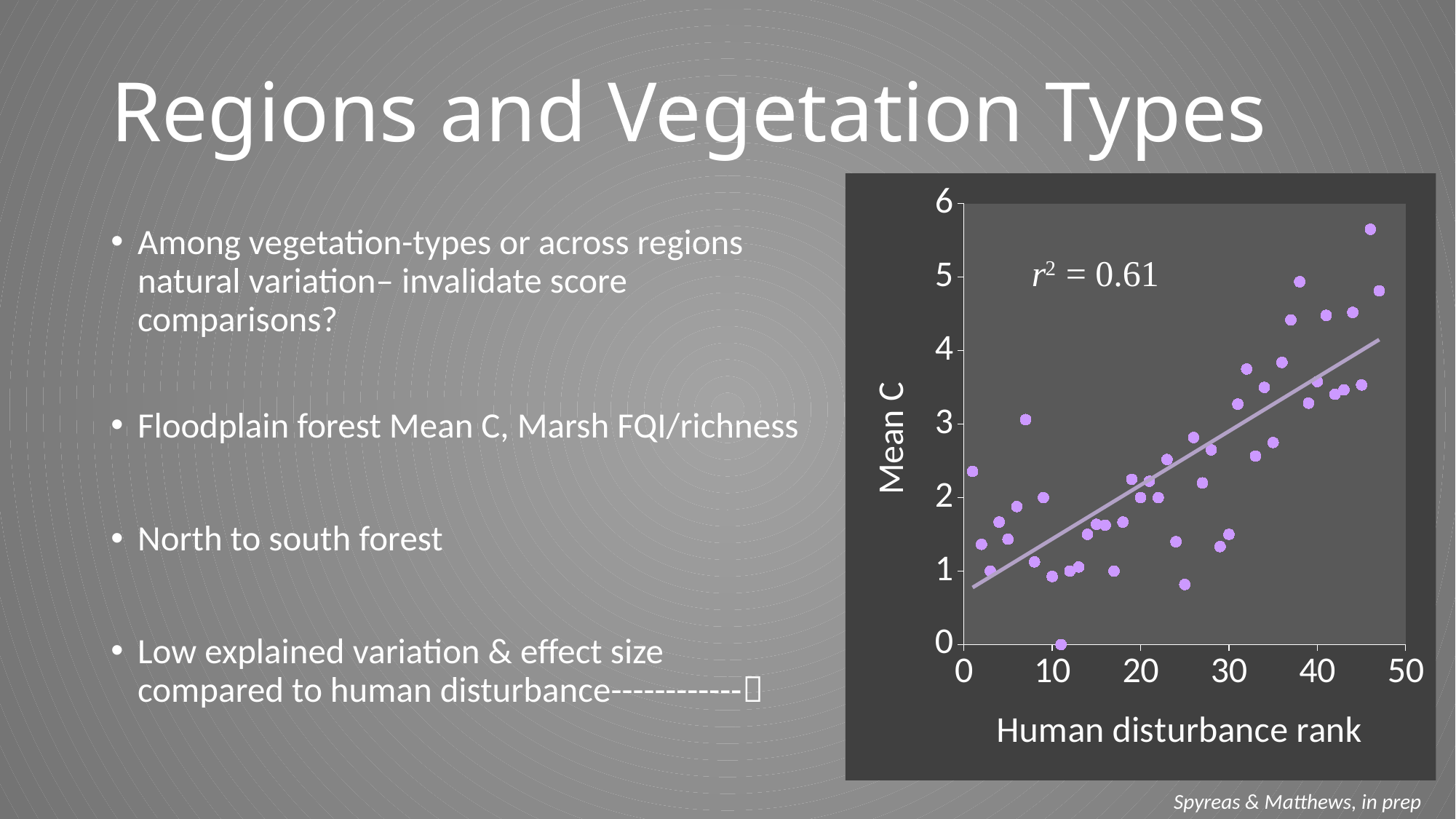
Is the Mean C value of the point at human disturbance rank 1 greater or less than 2? greater What kind of chart is shown on the slide? scatter chart Does the trend line on the chart slope upward or downward from left to right? upward What r² value is printed on the chart? r² = 0.61 Do the Mean C values generally rise or fall as human disturbance rank increases along the x axis? rise Is the Mean C value of the point near human disturbance rank 25 greater or less than 1? less Is the Mean C value of the highest point on the chart greater or less than 5? greater What is the highest tick value shown on the y axis of the chart? 6 What is the highest tick value shown on the x axis of the chart? 50 What is the label of the y axis of the chart? Mean C What is the label of the x axis of the chart? Human disturbance rank